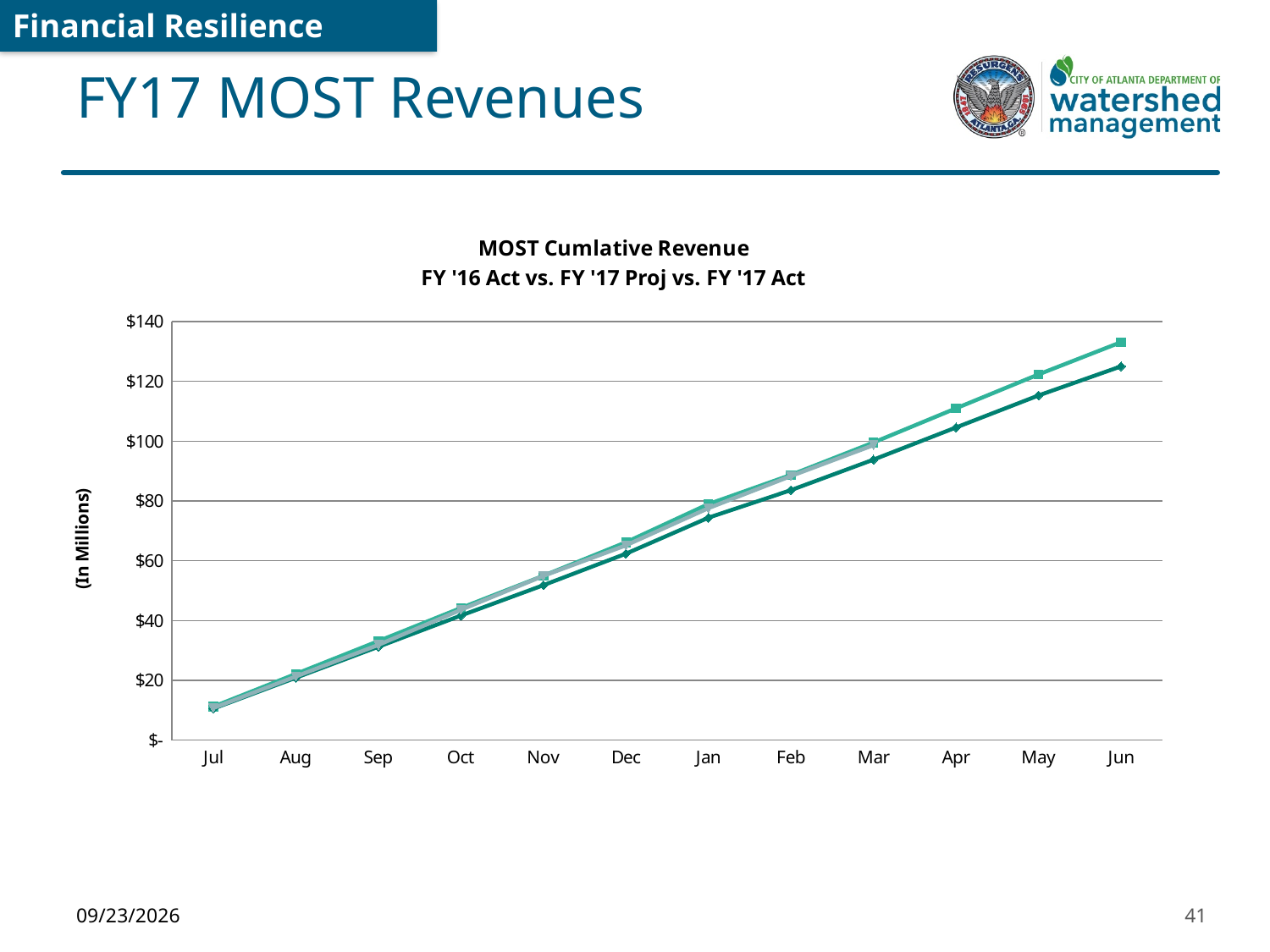
Is the Apr value for the line with square markers greater or less than $100? greater Do the values in the chart rise or fall from Jul to Jun? rise How many months are shown along the x axis of the chart? 12 Is the Jun value for the line with square markers greater or less than $120? greater What kind of chart is shown on the slide? line chart What is the label on the vertical axis of the chart? (In Millions) Is the Jul value for the line with diamond markers greater or less than $20? less What is the title of the chart? MOST Cumlative Revenue FY '16 Act vs. FY '17 Proj vs. FY '17 Act At Jun, is the line with square markers higher or lower than the line with diamond markers? higher Which month has the highest cumulative revenue on the chart? Jun Which month has the lowest cumulative revenue on the chart? Jul